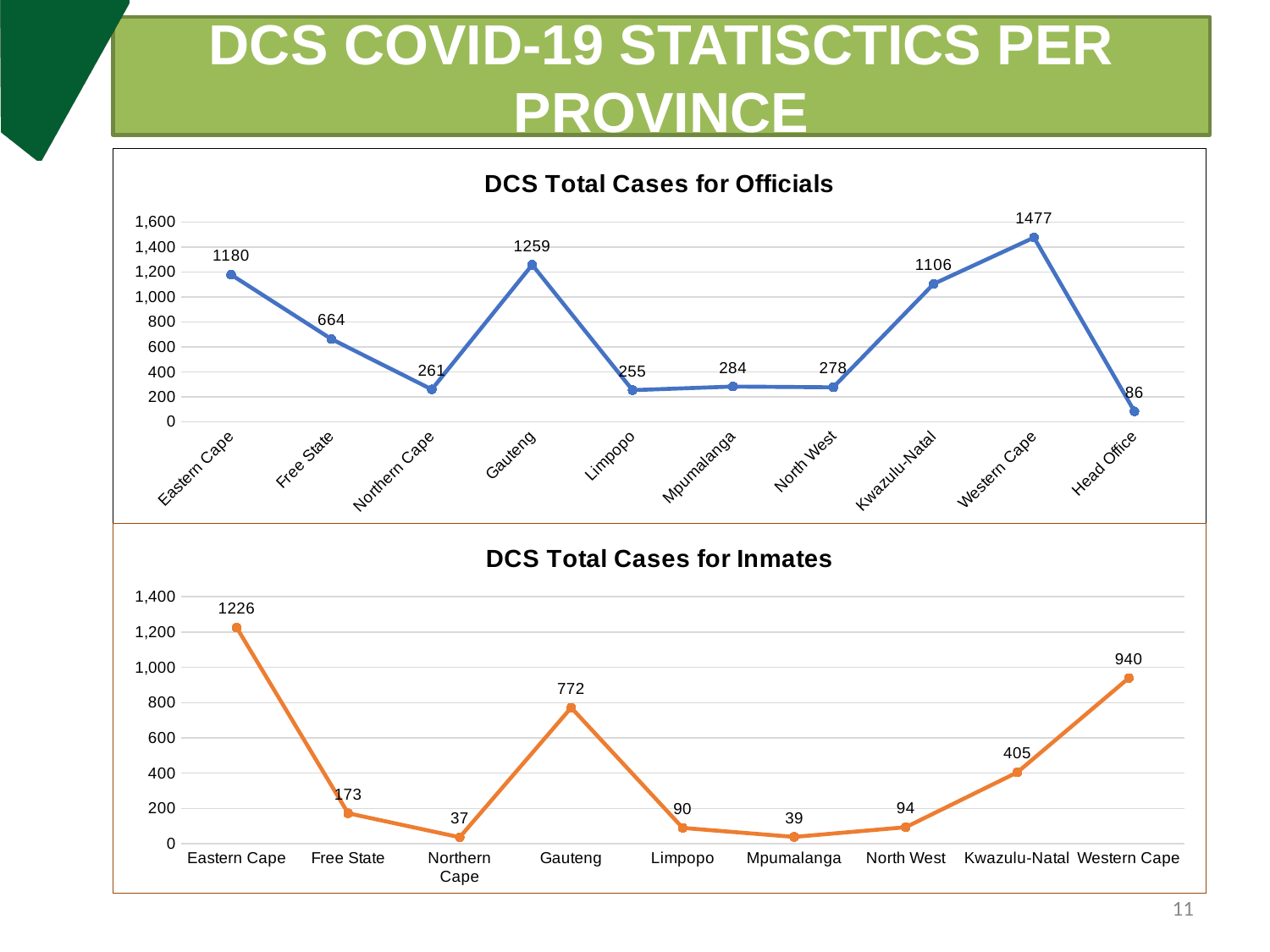
In the 'DCS Total Cases for Inmates' chart, what is the value for Mpumalanga? 39 In the 'DCS Total Cases for Officials' chart, which category has the lowest value? Head Office How many categories are plotted in the 'DCS Total Cases for Officials' chart? 10 In the 'DCS Total Cases for Officials' chart, which is larger, Free State or Kwazulu-Natal? Kwazulu-Natal In the 'DCS Total Cases for Inmates' chart, what is the difference between Eastern Cape and Western Cape? 286 How many categories are plotted in the 'DCS Total Cases for Inmates' chart? 9 What kind of chart is the 'DCS Total Cases for Inmates' chart? Line chart In the 'DCS Total Cases for Inmates' chart, which category has the lowest value? Northern Cape In the 'DCS Total Cases for Officials' chart, what is the value for Gauteng? 1259 In the 'DCS Total Cases for Officials' chart, which category has the highest value? Western Cape In the 'DCS Total Cases for Inmates' chart, what is the value for Kwazulu-Natal? 405 In the 'DCS Total Cases for Officials' chart, what is the difference between Western Cape and Head Office? 1391